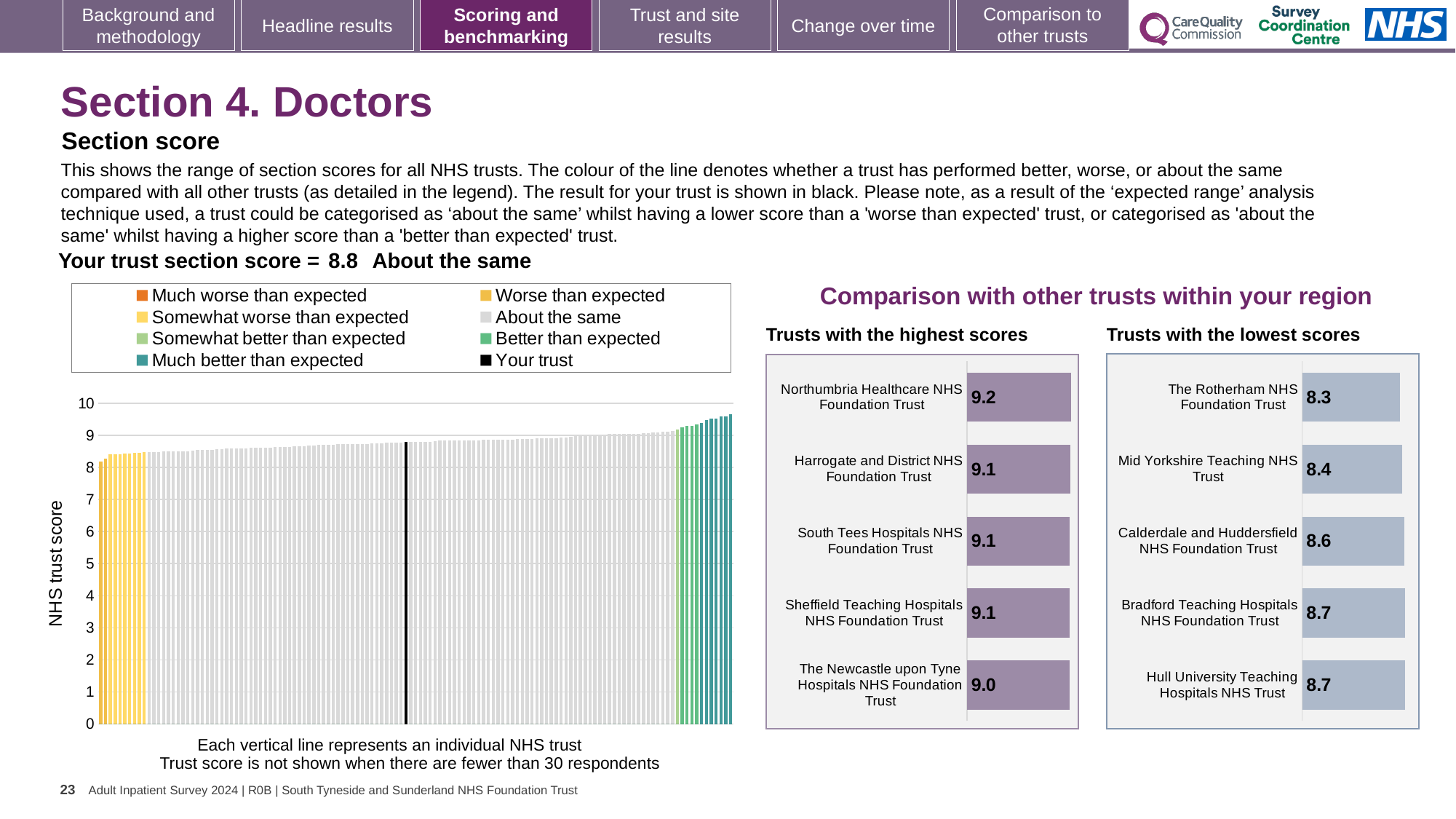
In the 'Trusts with the lowest scores' chart, what is the score for Mid Yorkshire Teaching NHS Trust? 8.4 In the 'Trusts with the highest scores' chart, which trust has the lowest score shown? The Newcastle upon Tyne Hospitals NHS Foundation Trust What type of chart is the large chart on the left showing NHS trust scores? Bar chart In the 'Trusts with the lowest scores' chart, which has the higher score: Calderdale and Huddersfield NHS Foundation Trust or Mid Yorkshire Teaching NHS Trust? Calderdale and Huddersfield NHS Foundation Trust In the large chart on the left, is the value for the black 'Your trust' bar greater or less than 8? greater In the 'Trusts with the highest scores' chart, what is the difference between the scores of Northumbria Healthcare NHS Foundation Trust and The Newcastle upon Tyne Hospitals NHS Foundation Trust? 0.2 In the large chart on the left, do the trust scores rise or fall from left to right along the x axis? Rise How many entries does the legend of the large chart on the left list? 8 In the 'Trusts with the highest scores' chart, what is the score for Northumbria Healthcare NHS Foundation Trust? 9.2 In the 'Trusts with the lowest scores' chart, what is the difference between the scores of Hull University Teaching Hospitals NHS Trust and The Rotherham NHS Foundation Trust? 0.4 In the 'Trusts with the lowest scores' chart, which trust has the lowest score? The Rotherham NHS Foundation Trust In the 'Trusts with the highest scores' chart, how many trusts are listed? 5